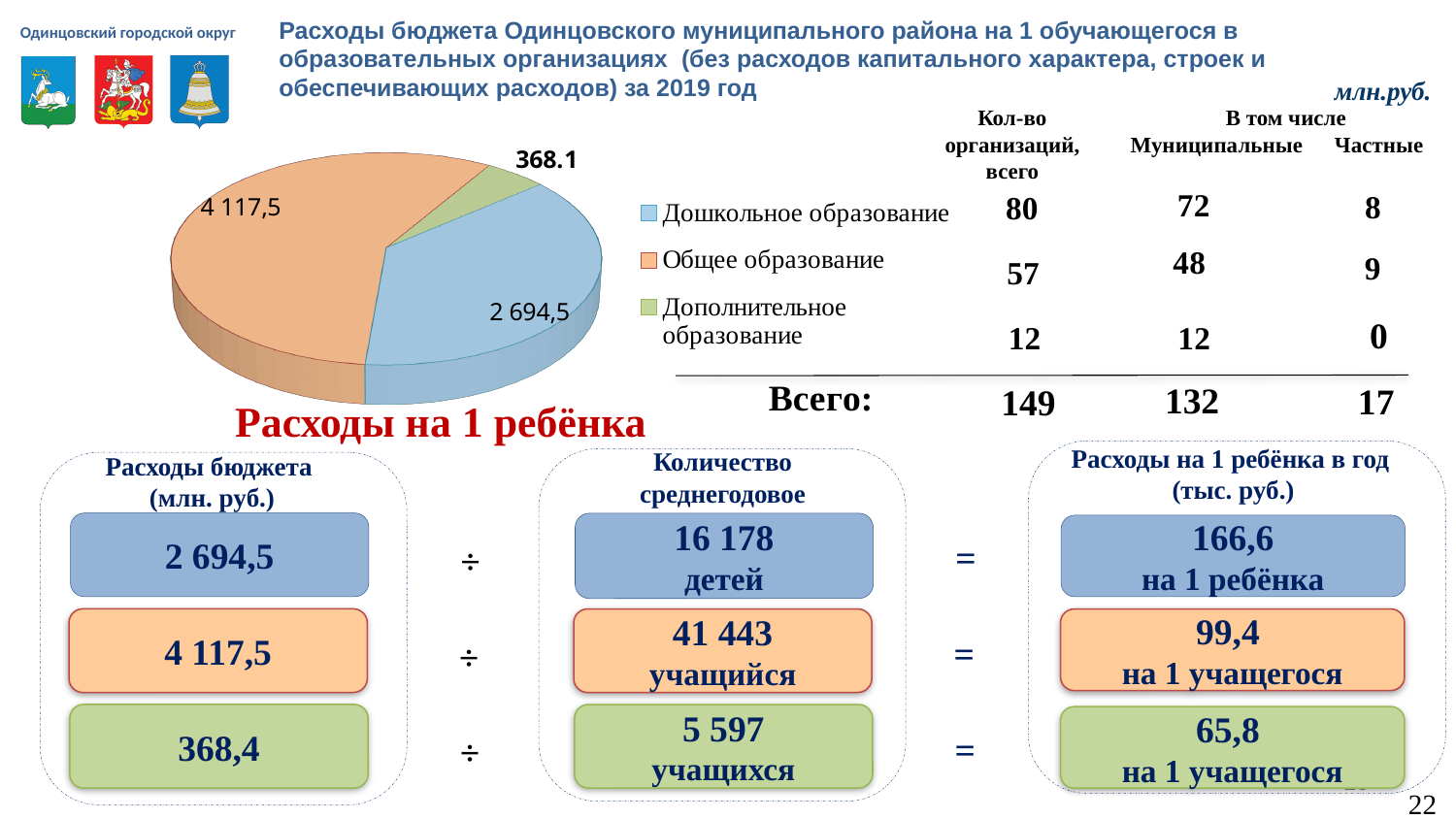
Which category has the smallest slice in the pie chart? Дополнительное образование What unit is indicated for the values in the pie chart? млн.руб. What is the difference between the values for Общее образование and Дошкольное образование in the pie chart? 1 423 What value is shown for Дополнительное образование in the pie chart? 368.1 What colour is the Дополнительное образование slice in the pie chart? green How many entries does the pie chart legend list? 3 What kind of chart is shown on the slide? pie chart Which category has the largest slice in the pie chart? Общее образование What value is shown for Дошкольное образование in the pie chart? 2 694,5 Which is larger in the pie chart: Дошкольное образование or Общее образование? Общее образование How many slices does the pie chart have? 3 What value is shown for Общее образование in the pie chart? 4 117,5